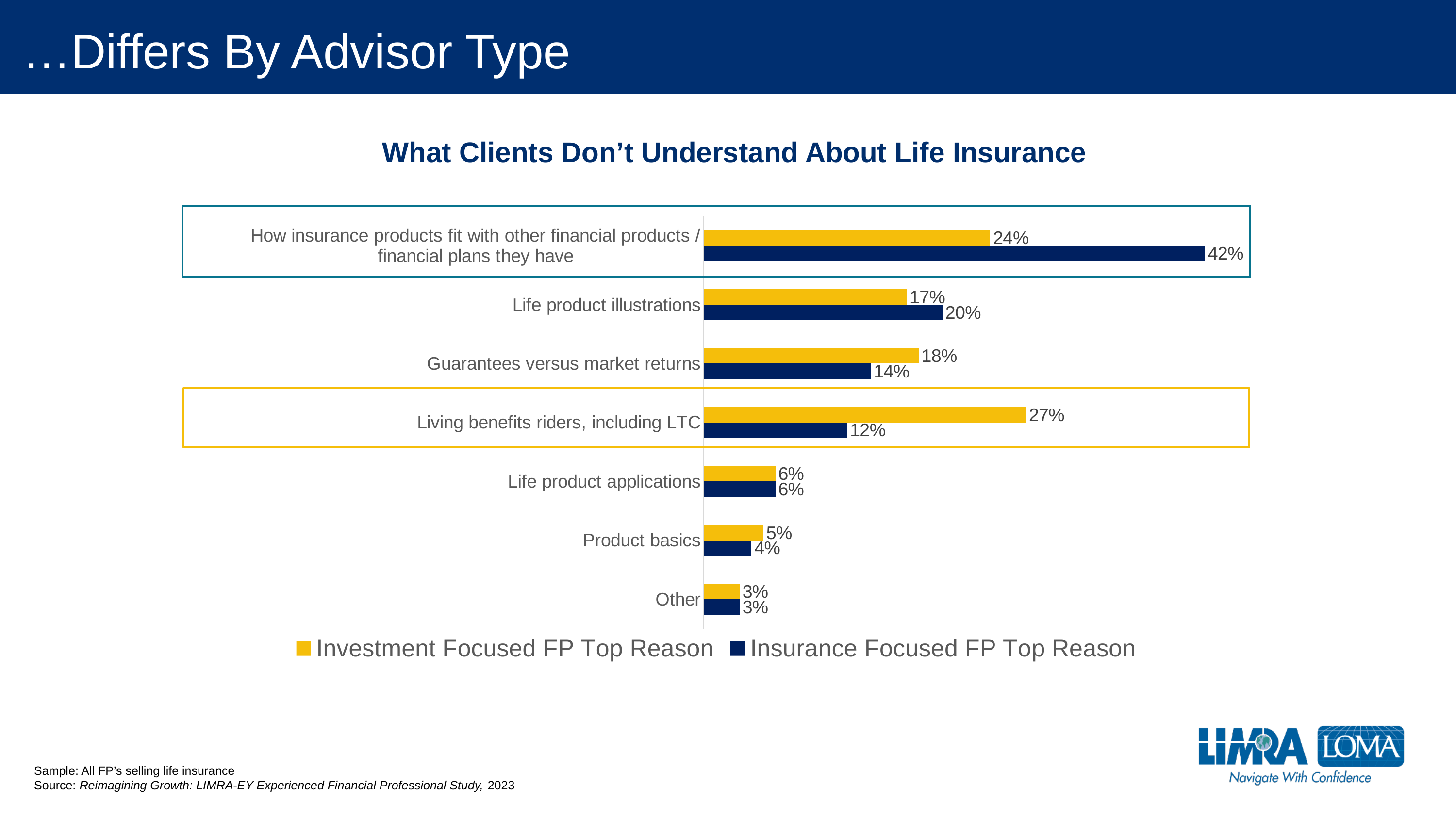
For "Life product illustrations", which series has the larger value: Investment Focused FP Top Reason or Insurance Focused FP Top Reason? Insurance Focused FP Top Reason Which colour represents the Investment Focused FP Top Reason series? Yellow How many series does the legend list? 2 What is the difference between the Insurance Focused and Investment Focused values for "How insurance products fit with other financial products / financial plans they have"? 18% What is the Insurance Focused FP Top Reason value for "How insurance products fit with other financial products / financial plans they have"? 42% What is the title of the chart? What Clients Don't Understand About Life Insurance Which category has the highest Investment Focused FP Top Reason value? Living benefits riders, including LTC What kind of chart is shown on the slide? Bar chart What is the Investment Focused FP Top Reason value for "Living benefits riders, including LTC"? 27% What is the Insurance Focused FP Top Reason value for "Guarantees versus market returns"? 14% Which category has the lowest Insurance Focused FP Top Reason value? Other How many categories are shown in the chart? 7